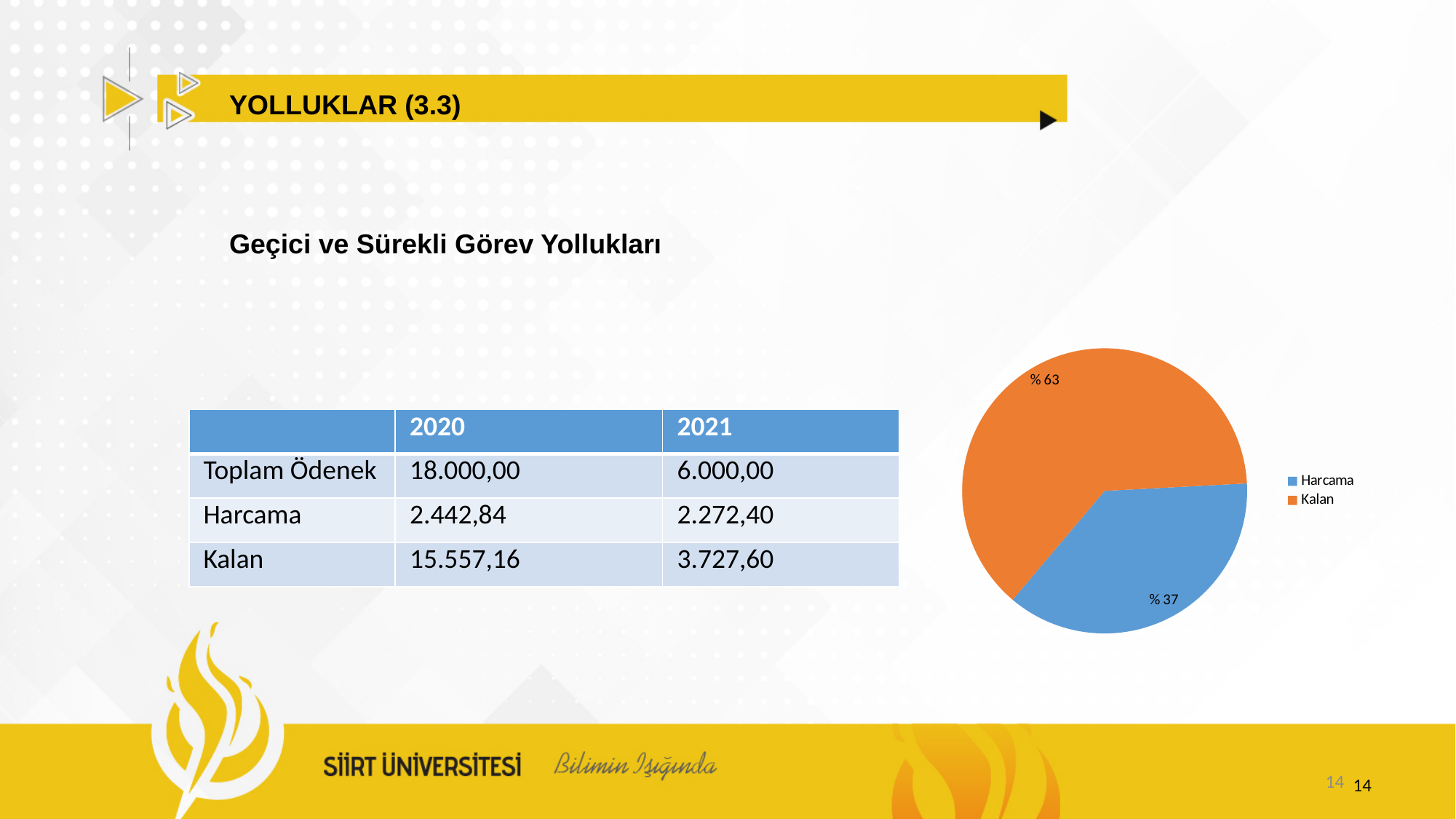
Which slice of the pie chart is the smallest? Harcama What share of the pie chart does Kalan represent? % 63 Which slice of the pie chart is the largest? Kalan What share of the pie chart does Harcama represent? % 37 How many slices does the pie chart have? 2 What colour is the Kalan slice in the pie chart? orange What is the difference in percentage points between the Kalan and Harcama slices of the pie chart? 26 How many entries does the pie chart legend list? 2 What colour is the Harcama slice in the pie chart? blue What kind of chart is shown on the slide? pie chart Which is larger in the pie chart, Harcama or Kalan? Kalan